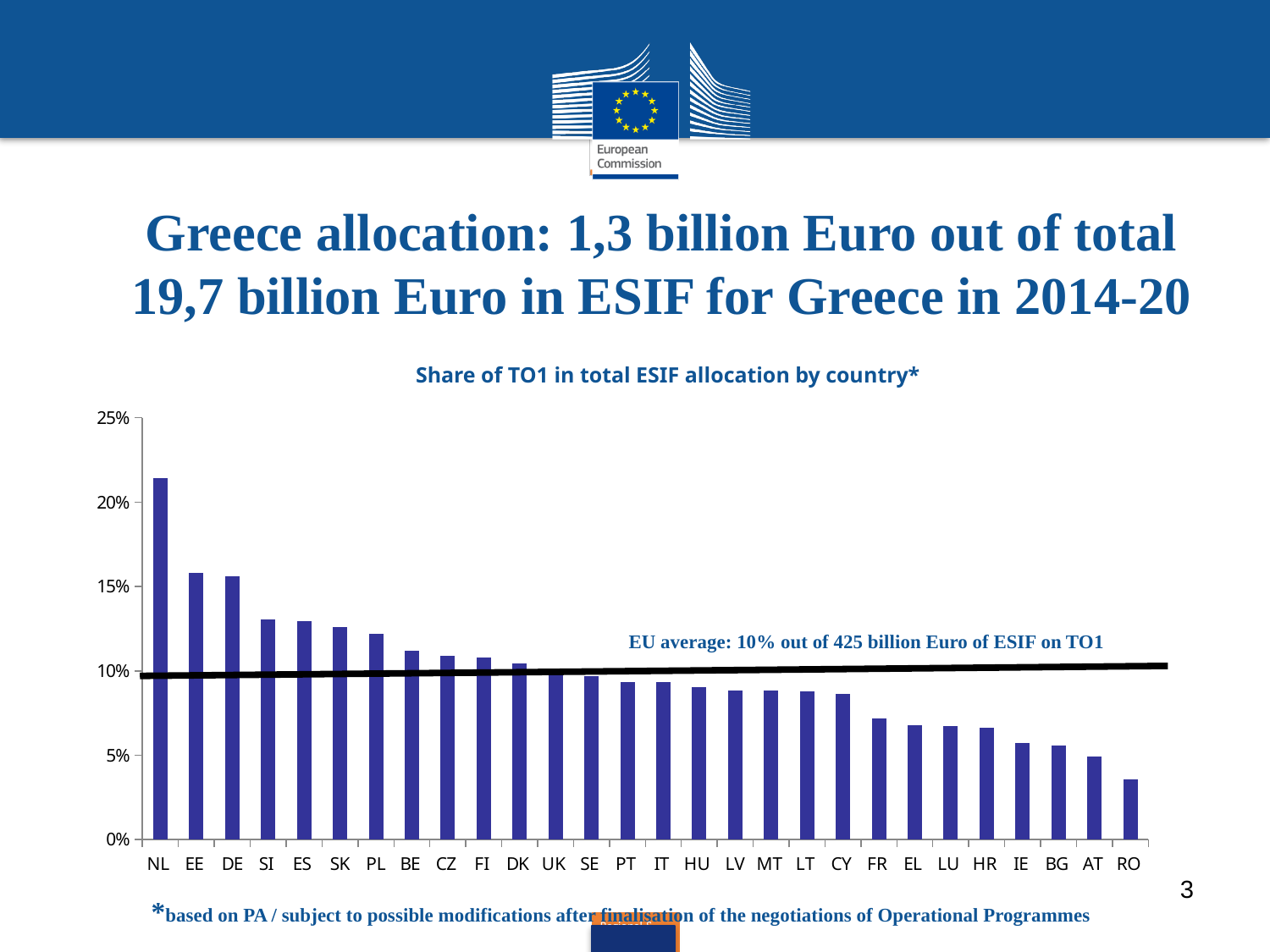
What is the title of the chart? Share of TO1 in total ESIF allocation by country* Which has a larger share of TO1, DE or RO? DE Is the value for EE greater or less than 15%? greater How many countries are shown on the x axis of the chart? 28 Which country has the lowest share of TO1 in total ESIF allocation? RO What kind of chart is shown on the slide? bar chart Is the value for RO greater or less than 5%? less Is the value for NL greater or less than 20%? greater Do the bar values rise or fall from left to right along the x axis? fall Which country has the highest share of TO1 in total ESIF allocation? NL Which has a larger share of TO1, NL or EE? NL